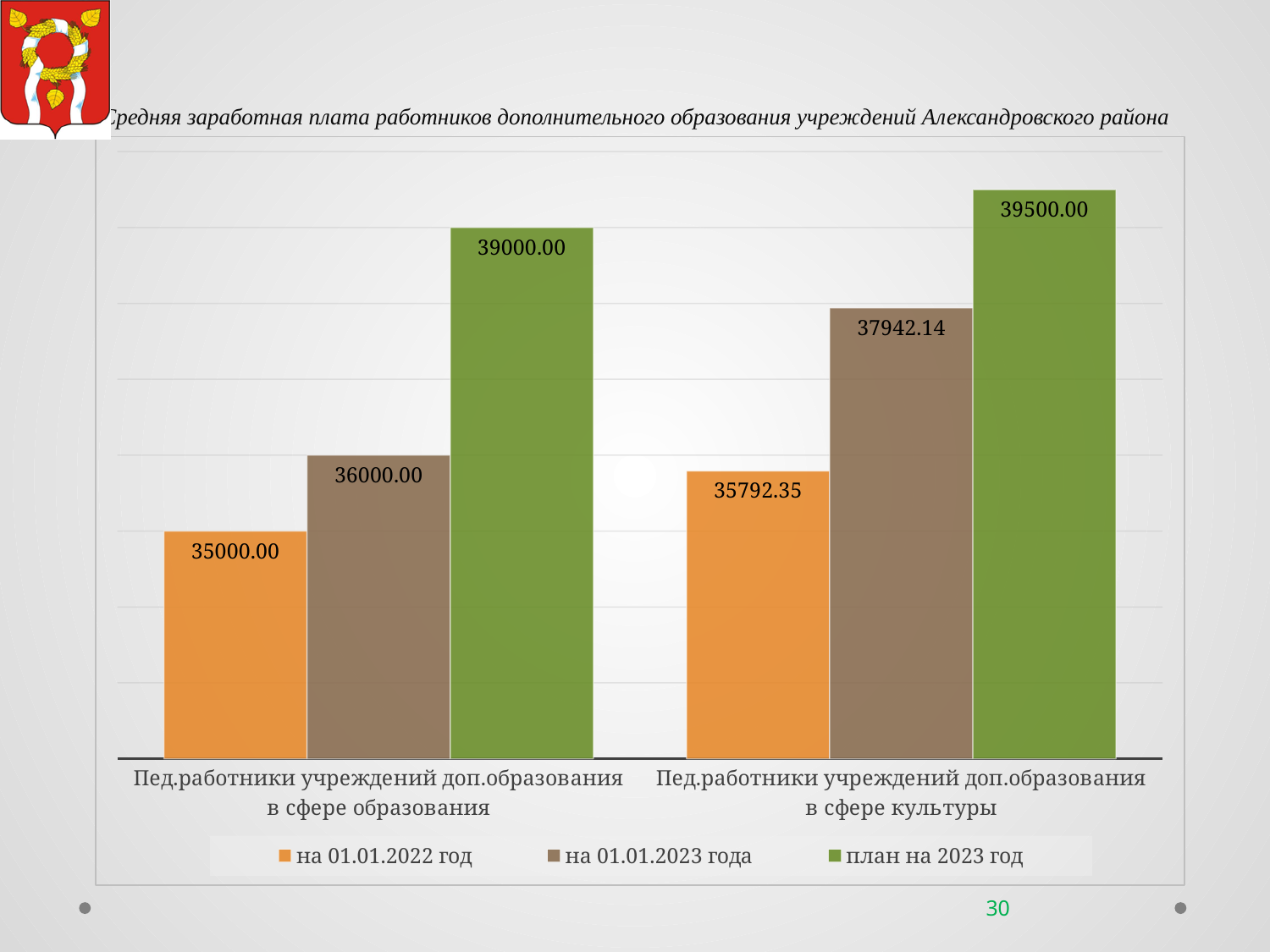
How many series does the legend list? 3 How many categories are shown on the x axis? 2 What kind of chart is shown on the slide? bar chart Which category has the highest value for 'план на 2023 год'? Пед.работники учреждений доп.образования в сфере культуры What colour are the bars for 'план на 2023 год'? green What is the difference between 'план на 2023 год' and 'на 01.01.2023 года' for 'Пед.работники учреждений доп.образования в сфере образования'? 3000.00 What is the value for 'на 01.01.2023 года' for 'Пед.работники учреждений доп.образования в сфере культуры'? 37942.14 What is the value for 'план на 2023 год' for 'Пед.работники учреждений доп.образования в сфере образования'? 39000.00 Which series has the lowest value for 'Пед.работники учреждений доп.образования в сфере образования'? на 01.01.2022 год What is the value for 'на 01.01.2022 год' for 'Пед.работники учреждений доп.образования в сфере культуры'? 35792.35 Which is larger: 'на 01.01.2023 года' for 'в сфере образования' or 'на 01.01.2023 года' for 'в сфере культуры'? в сфере культуры What is the value for 'на 01.01.2022 год' for 'Пед.работники учреждений доп.образования в сфере образования'? 35000.00